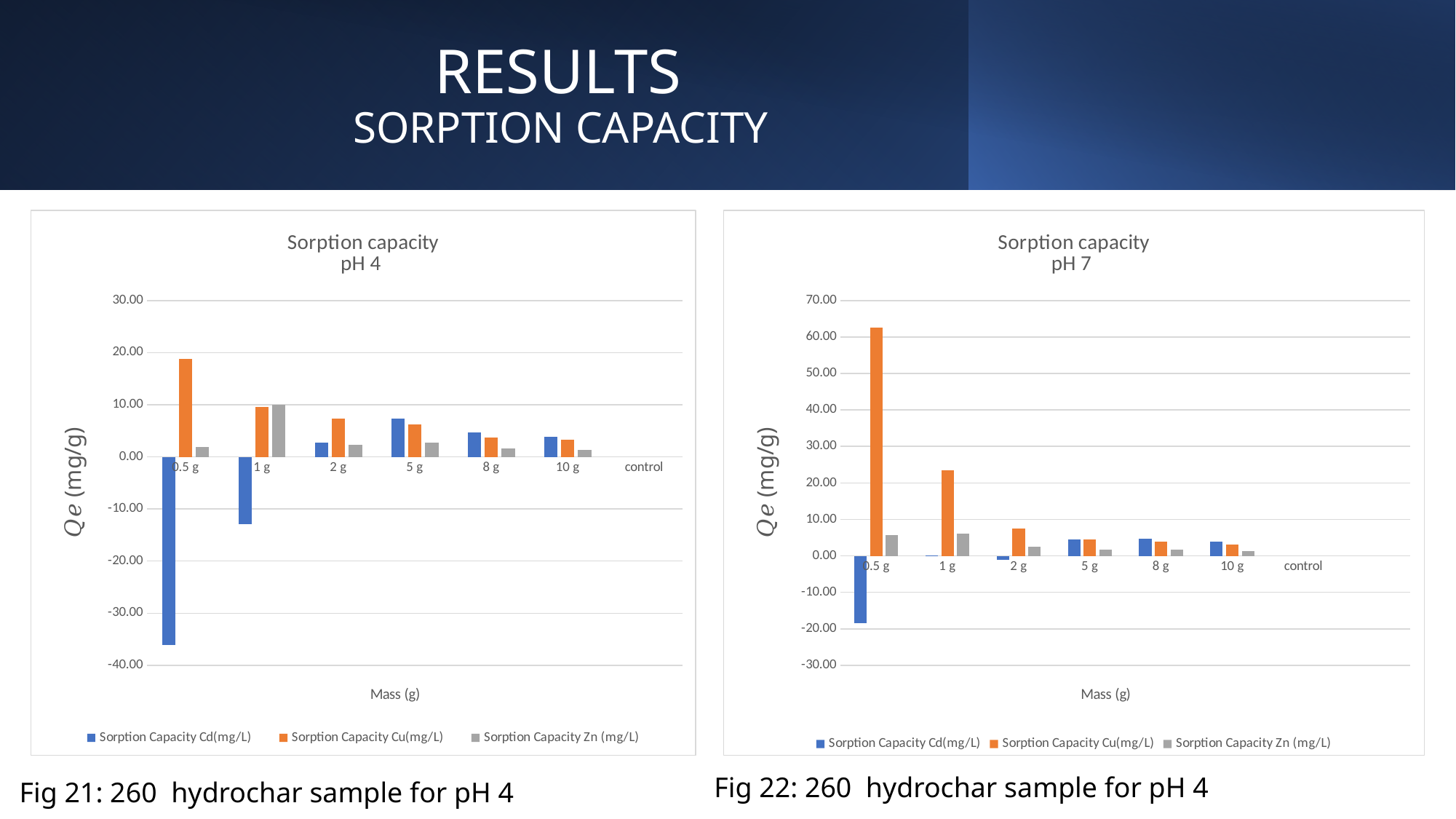
In the 'Sorption capacity pH 4' chart, how many mass categories are shown on the x axis? 7 In the 'Sorption capacity pH 4' chart, is the Sorption Capacity Cd value for 0.5 g greater or less than -30.00? less In the 'Sorption capacity pH 7' chart, is the Sorption Capacity Cu value for 0.5 g greater or less than 50.00? greater In the 'Sorption capacity pH 4' chart, which mass has the highest Sorption Capacity Cu value? 0.5 g In the 'Sorption capacity pH 4' chart, how many series does the legend list? 3 In the 'Sorption capacity pH 4' chart, is the Sorption Capacity Cu value for 0.5 g greater or less than 10.00? greater In the 'Sorption capacity pH 4' chart, which mass has the lowest Sorption Capacity Cd value? 0.5 g What kind of chart is the 'Sorption capacity pH 4' chart on the left? Bar chart In the 'Sorption capacity pH 7' chart, does the Sorption Capacity Cu value rise or fall from 0.5 g to 10 g? Fall In the 'Sorption capacity pH 7' chart, which mass has the highest Sorption Capacity Cu value? 0.5 g In the 'Sorption capacity pH 7' chart, at 1 g, which is larger: Sorption Capacity Cu or Sorption Capacity Zn? Sorption Capacity Cu